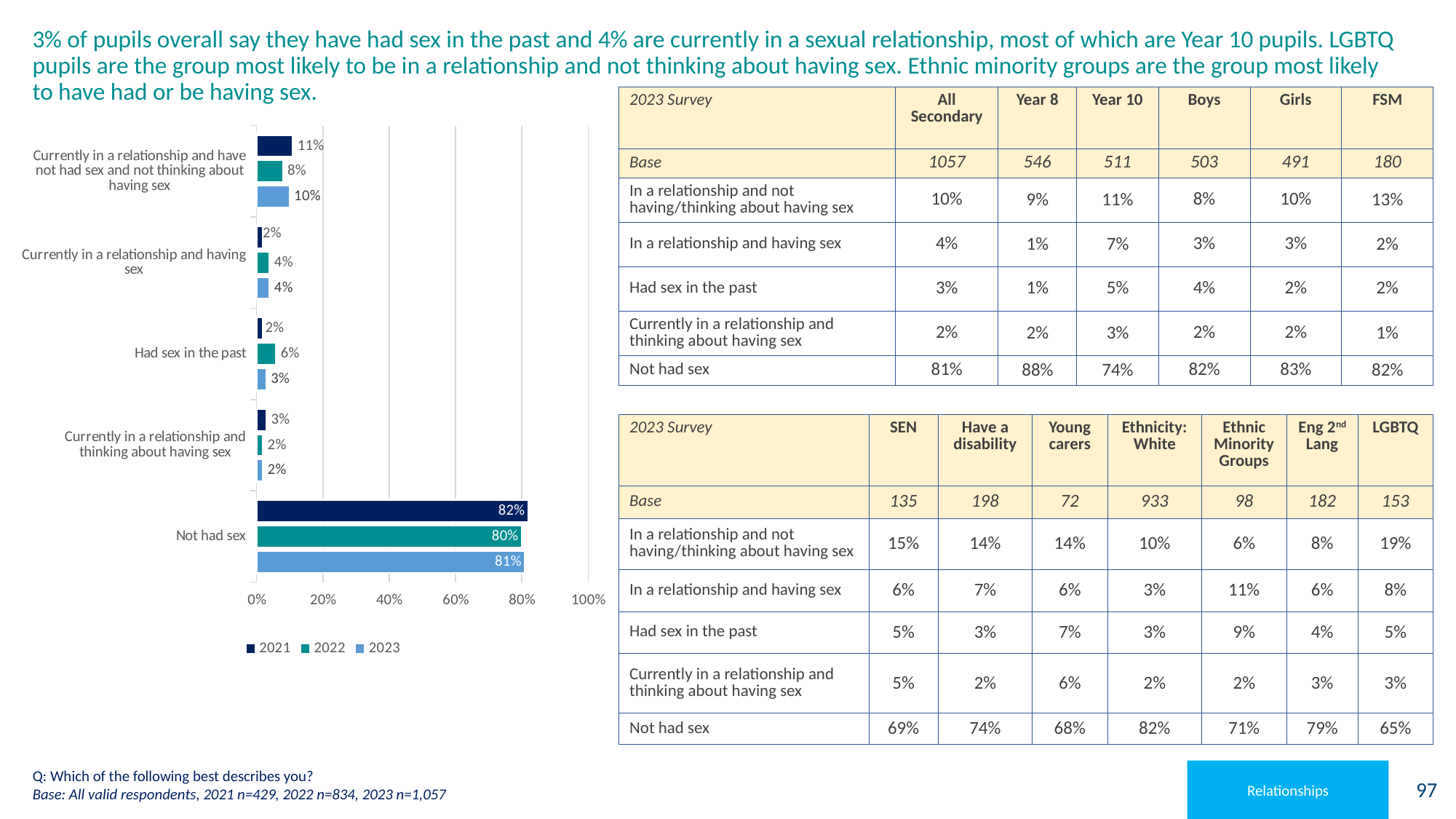
Which years are listed in the chart legend? 2021, 2022, 2023 How many series does the chart legend list? 3 What is the 2021 value for 'Currently in a relationship and have not had sex and not thinking about having sex'? 11% Which category has the highest value for 2021? Not had sex Which year has the lowest value for 'Not had sex'? 2022 What is the 2023 value for 'Not had sex'? 81% What is the difference between the 2021 and 2022 values for 'Not had sex'? 2% What type of chart is shown on the slide? Bar chart How many categories are plotted on the chart? 5 Is the 2023 value for 'Not had sex' greater or less than 60%? greater Which is larger for 'Had sex in the past': the 2022 value or the 2023 value? 2022 What is the 2022 value for 'Had sex in the past'? 6%